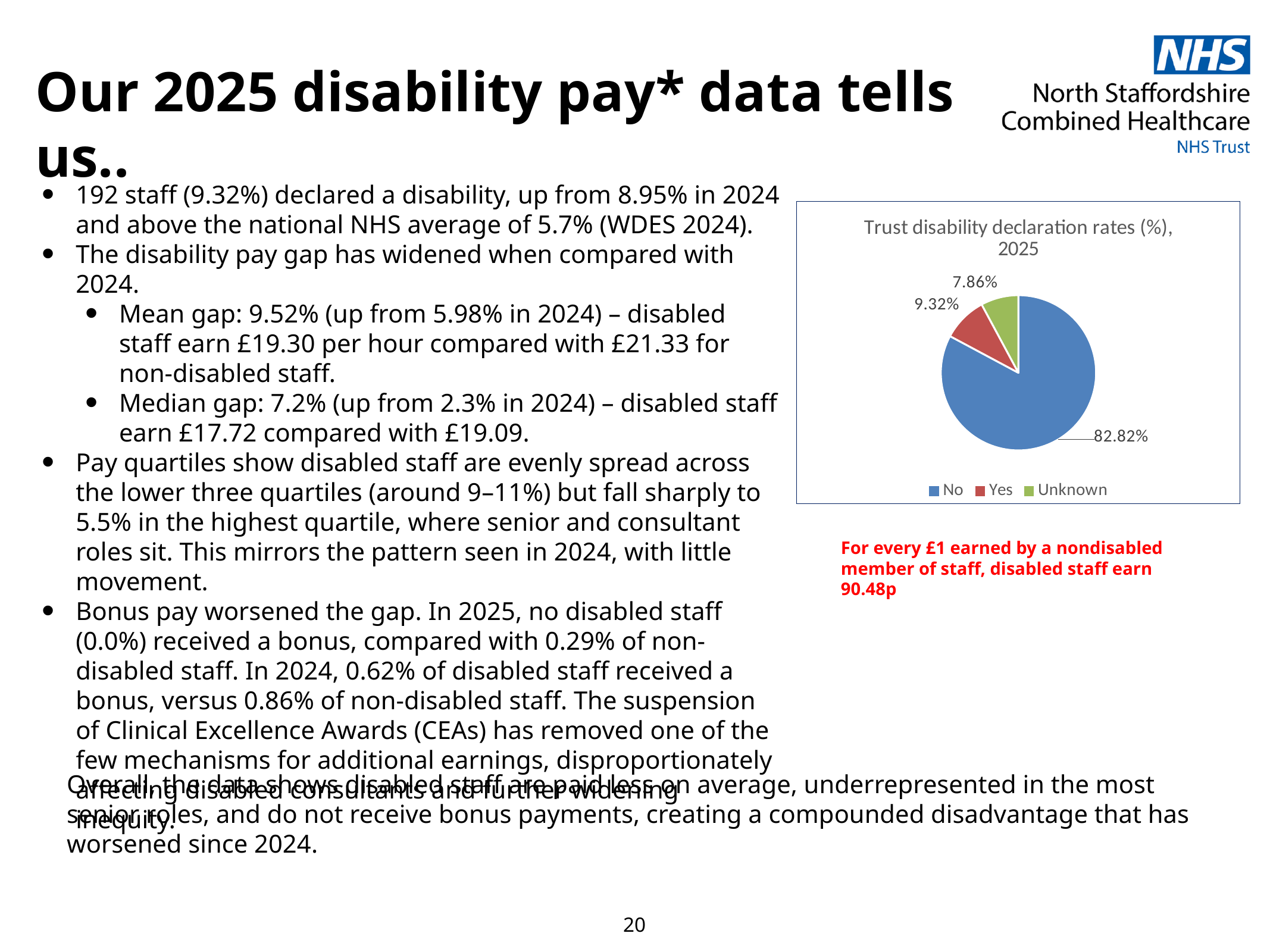
Which category has the largest slice of the pie? No What colour is the 'Unknown' slice in the pie chart? Green How many categories does the legend list? 3 What is the title of the chart? Trust disability declaration rates (%), 2025 Which is larger, the 'Yes' slice or the 'Unknown' slice? Yes What kind of chart is shown on the slide? Pie chart What percentage of the pie is the 'Unknown' slice? 7.86% Which category has the smallest slice of the pie? Unknown What percentage of the pie is the 'Yes' slice? 9.32% What is the difference between the 'Yes' and 'Unknown' slices? 1.46% What percentage of the pie is the 'No' slice? 82.82% What is the difference between the 'No' and 'Yes' slices? 73.50%